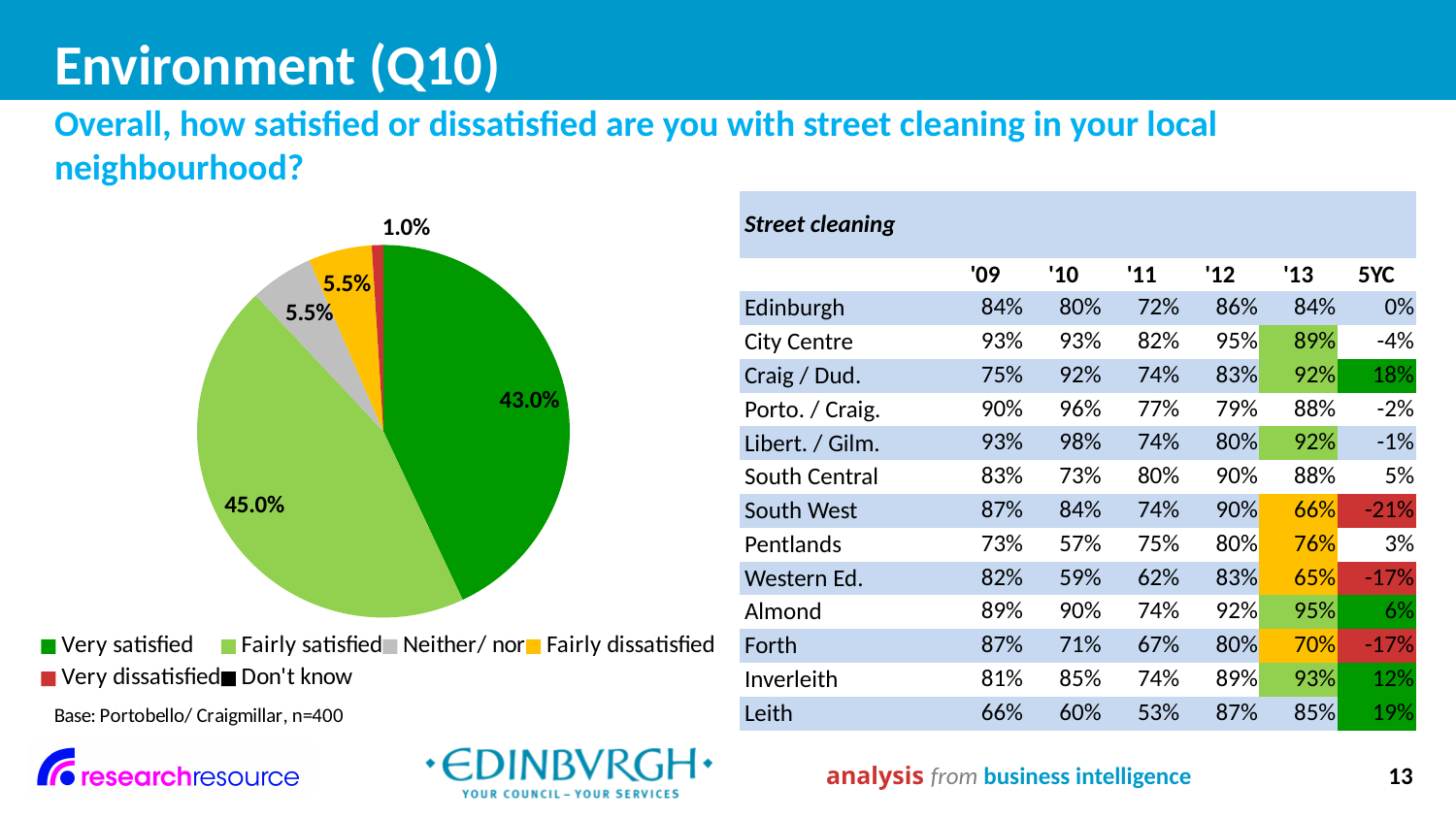
In the pie chart, what is the difference in percentage points between 'Fairly satisfied' and 'Very satisfied'? 2.0 percentage points In the pie chart, what is the combined share of 'Very satisfied' and 'Fairly satisfied'? 88.0% Which category has the largest slice in the pie chart? Fairly satisfied In the pie chart, what percentage of respondents answered 'Neither/ nor'? 5.5% In the pie chart, what percentage of respondents are 'Fairly satisfied'? 45.0% Which category has the smallest slice with a printed label in the pie chart? Very dissatisfied In the pie chart, what percentage of respondents are 'Very satisfied' with street cleaning? 43.0% In the pie chart, what percentage of respondents are 'Very dissatisfied'? 1.0% How many entries does the pie chart's legend list? 6 What is the base stated beneath the pie chart? Portobello/ Craigmillar, n=400 What type of chart is shown on the left of the slide? Pie chart In the pie chart, which is larger: the 'Very satisfied' slice or the 'Fairly satisfied' slice? Fairly satisfied